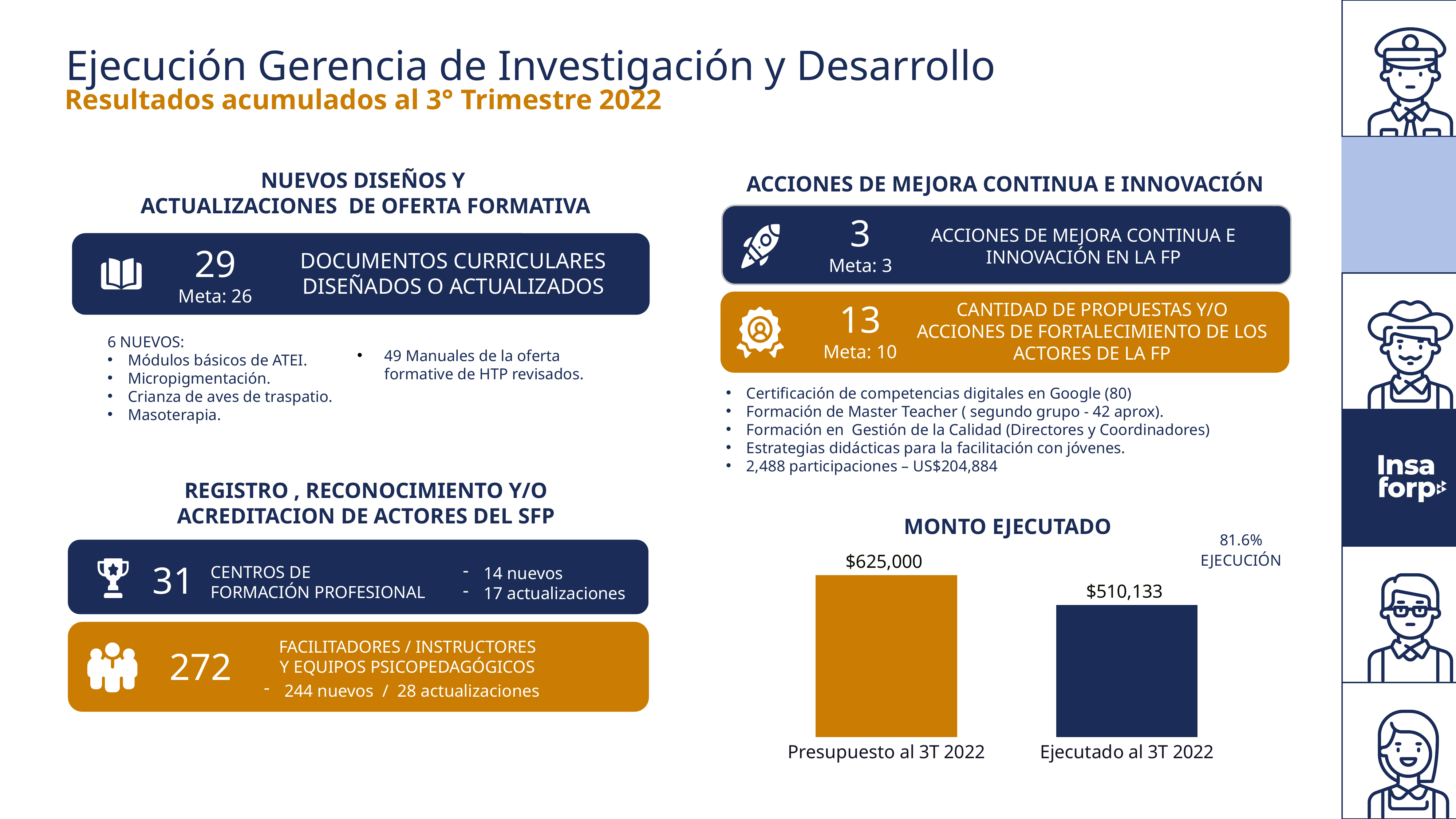
In the MONTO EJECUTADO chart, which is larger: Presupuesto al 3T 2022 or Ejecutado al 3T 2022? Presupuesto al 3T 2022 Do the values in the MONTO EJECUTADO chart rise or fall from left to right? Fall What kind of chart is the MONTO EJECUTADO chart? Bar chart What is the title of the chart on the slide? MONTO EJECUTADO Which category has the lowest value in the MONTO EJECUTADO chart? Ejecutado al 3T 2022 How many categories are shown in the MONTO EJECUTADO chart? 2 What execution percentage is shown next to the MONTO EJECUTADO chart? 81.6% Which category has the highest value in the MONTO EJECUTADO chart? Presupuesto al 3T 2022 What is the difference between Presupuesto al 3T 2022 and Ejecutado al 3T 2022 in the MONTO EJECUTADO chart? $114,867 What is the value for Presupuesto al 3T 2022 in the MONTO EJECUTADO chart? $625,000 What is the value for Ejecutado al 3T 2022 in the MONTO EJECUTADO chart? $510,133